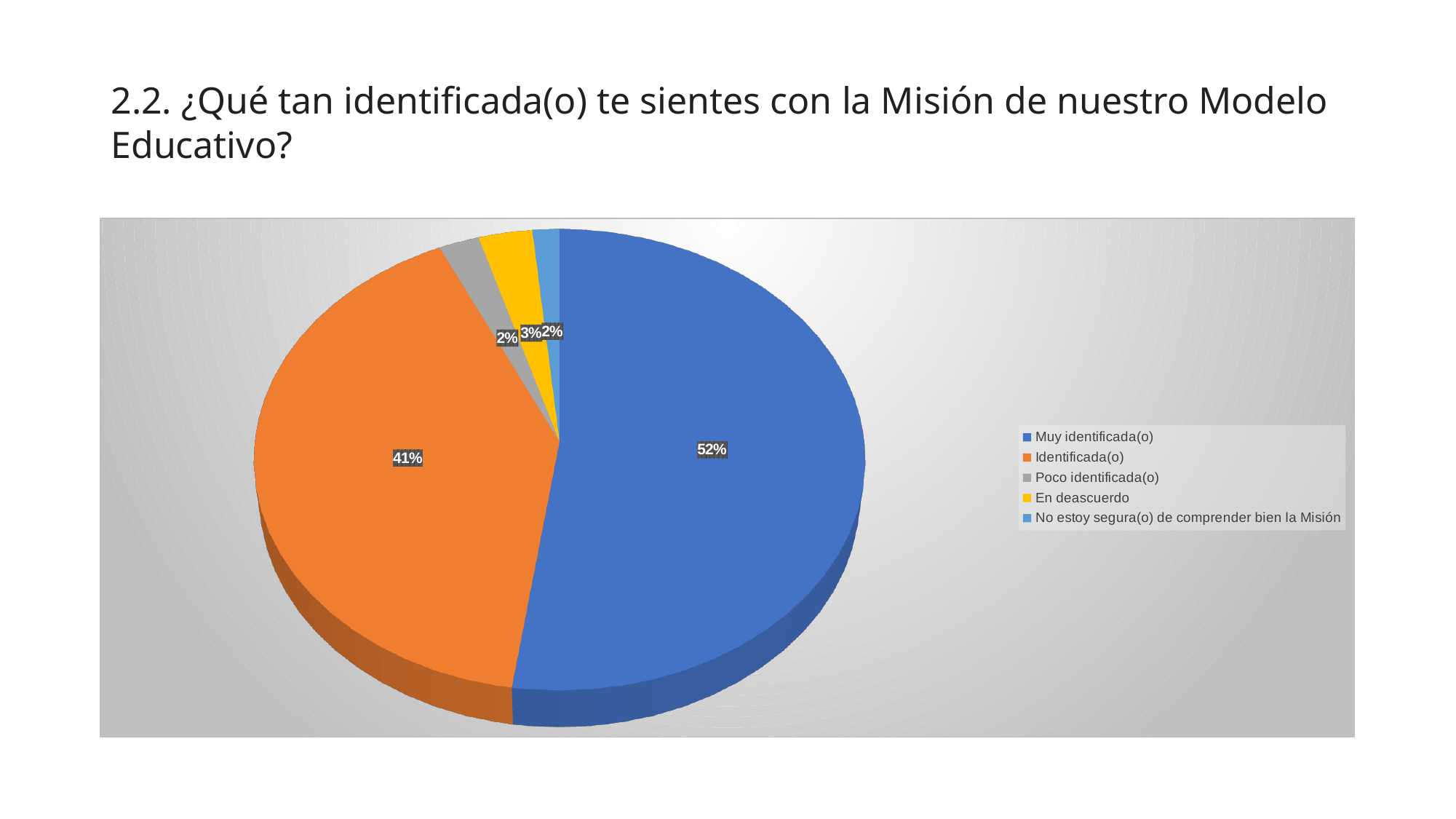
What percentage of respondents answered "Identificada(o)"? 41% What percentage of respondents answered "No estoy segura(o) de comprender bien la Misión"? 2% Which is larger, the share for "En deascuerdo" or the share for "Poco identificada(o)"? En deascuerdo What percentage of respondents answered "Poco identificada(o)"? 2% What percentage of respondents answered "Muy identificada(o)"? 52% How many categories does the pie chart have? 5 What is the difference in percentage points between "Muy identificada(o)" and "Identificada(o)"? 11 What colour is the slice for "Identificada(o)"? Orange What percentage of respondents answered "En deascuerdo"? 3% What is the combined share of "Muy identificada(o)" and "Identificada(o)"? 93% What type of chart is shown on the slide? Pie chart Which category has the largest share of the pie? Muy identificada(o)